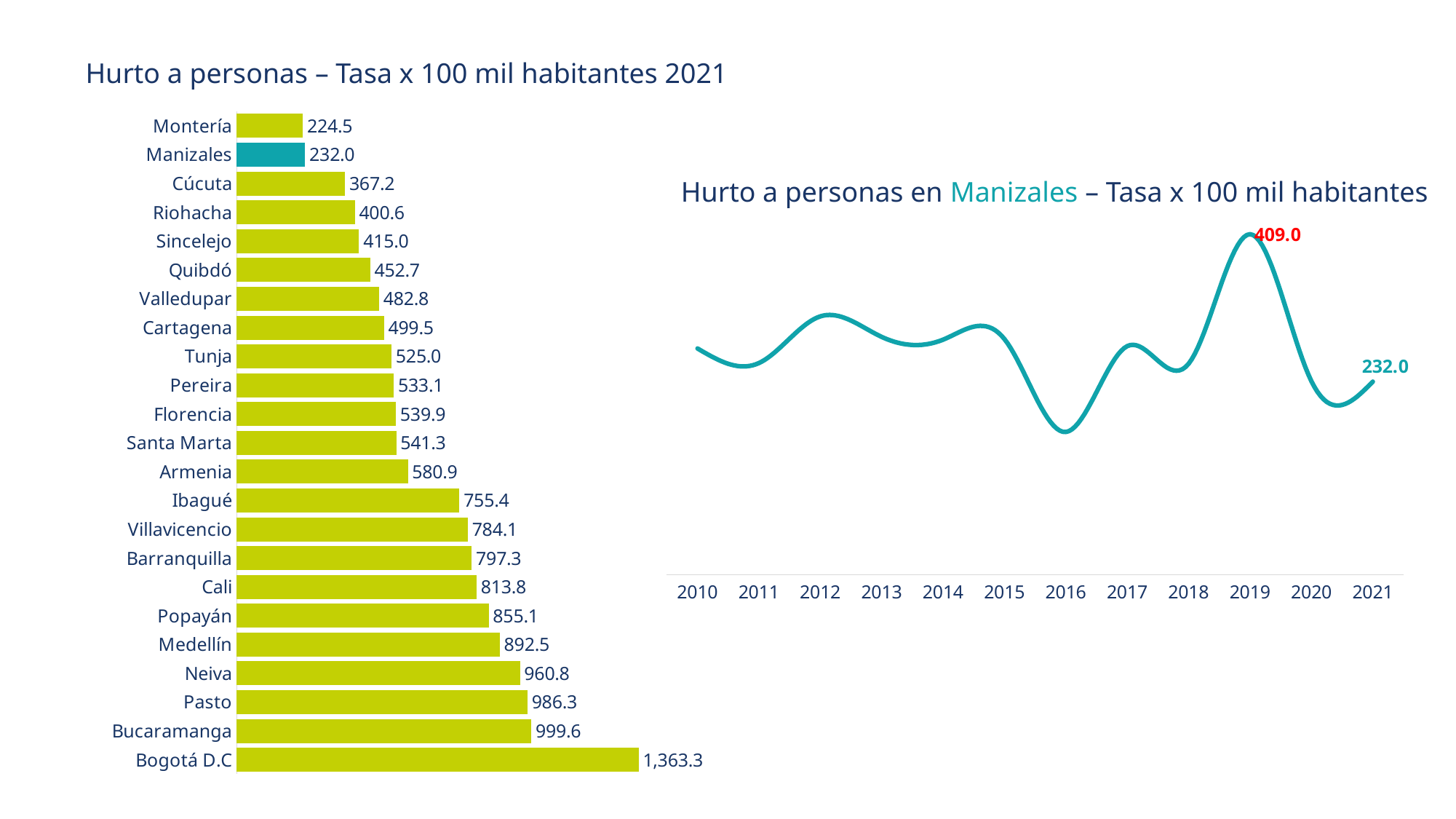
In the line chart 'Hurto a personas en Manizales – Tasa x 100 mil habitantes', does the value rise or fall from 2019 to 2021? Fall In the bar chart 'Hurto a personas – Tasa x 100 mil habitantes 2021', what is the difference between the values for Bogotá D.C and Bucaramanga? 363.7 In the bar chart 'Hurto a personas – Tasa x 100 mil habitantes 2021', what is the value for Bucaramanga? 999.6 In the bar chart 'Hurto a personas – Tasa x 100 mil habitantes 2021', which is larger, the value for Cali or the value for Barranquilla? Cali In the bar chart 'Hurto a personas – Tasa x 100 mil habitantes 2021', which city has the lowest value? Montería How many years are shown on the x axis of the line chart 'Hurto a personas en Manizales – Tasa x 100 mil habitantes'? 12 In the line chart 'Hurto a personas en Manizales – Tasa x 100 mil habitantes', what is the value for 2021? 232.0 How many cities are shown in the bar chart 'Hurto a personas – Tasa x 100 mil habitantes 2021'? 23 In the bar chart 'Hurto a personas – Tasa x 100 mil habitantes 2021', which city has the highest value? Bogotá D.C What kind of chart is the chart on the left of the slide? Bar chart In the line chart 'Hurto a personas en Manizales – Tasa x 100 mil habitantes', what is the value for 2019? 409.0 In the bar chart 'Hurto a personas – Tasa x 100 mil habitantes 2021', what is the value for Manizales? 232.0